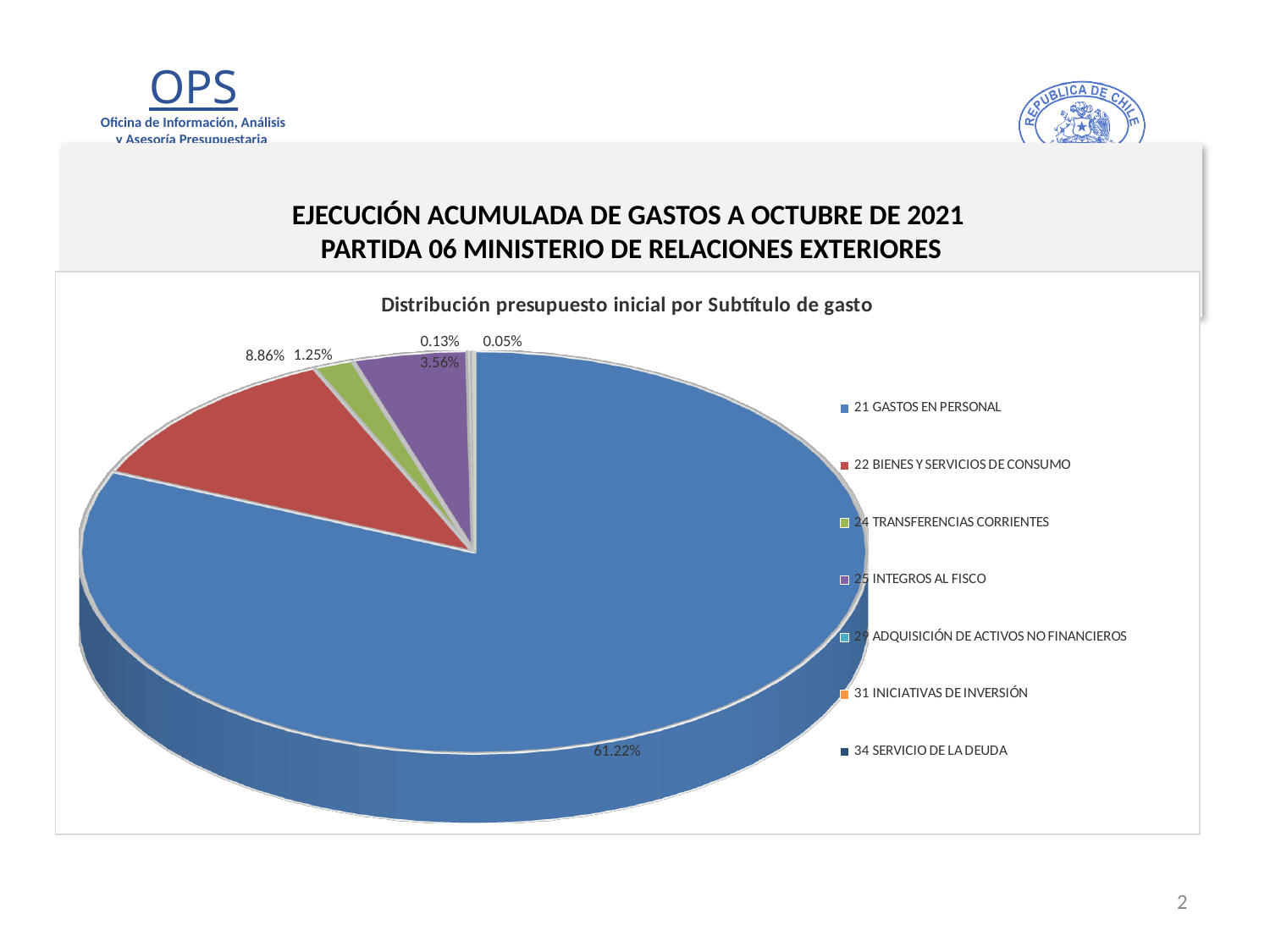
How many categories does the chart legend list? 7 Which is larger, the share for 24 TRANSFERENCIAS CORRIENTES or the share for 25 INTEGROS AL FISCO? 25 INTEGROS AL FISCO What colour is the slice for 22 BIENES Y SERVICIOS DE CONSUMO? Red What share of the pie does 25 INTEGROS AL FISCO represent? 3.56% Which is larger, the share for 22 BIENES Y SERVICIOS DE CONSUMO or the share for 25 INTEGROS AL FISCO? 22 BIENES Y SERVICIOS DE CONSUMO What share of the pie does 21 GASTOS EN PERSONAL represent? 61.22% What type of chart is shown on the slide? Pie chart What share of the pie does 22 BIENES Y SERVICIOS DE CONSUMO represent? 8.86% What is the title of the chart? Distribución presupuesto inicial por Subtítulo de gasto Which category has the largest slice of the pie? 21 GASTOS EN PERSONAL What is the difference in percentage points between the share for 21 GASTOS EN PERSONAL and the share for 22 BIENES Y SERVICIOS DE CONSUMO? 52.36